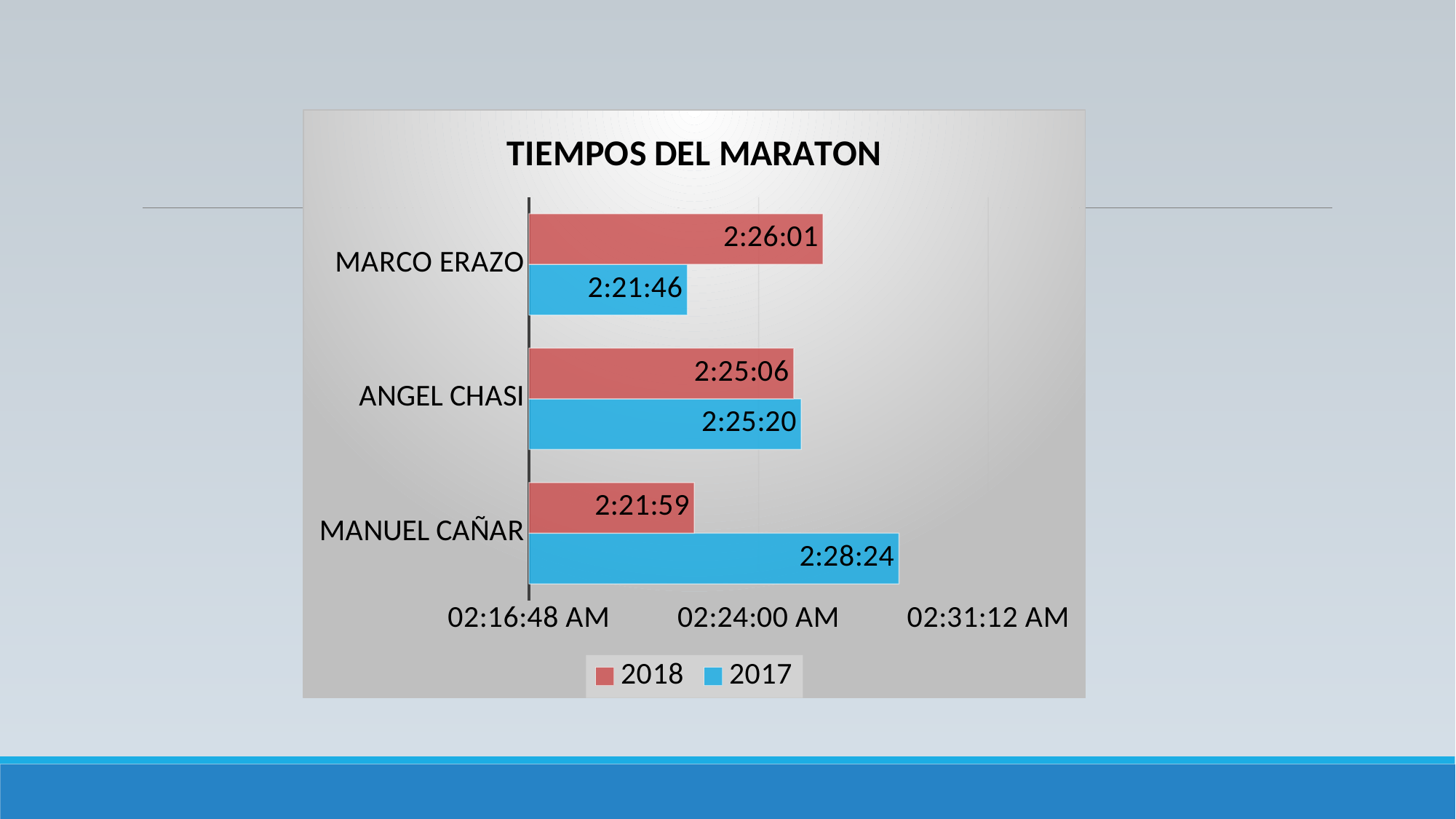
What is the title of the chart? TIEMPOS DEL MARATON What is the 2018 time for MARCO ERAZO? 2:26:01 How many runners are shown on the chart? 3 What is the 2017 time for MANUEL CAÑAR? 2:28:24 What type of chart is shown on the slide? bar chart How many series does the legend list? 2 Which colour represents the 2018 series? red For ANGEL CHASI, which year's time is longer, 2018 or 2017? 2017 Which runner has the shortest 2018 time? MANUEL CAÑAR What is the 2017 time for ANGEL CHASI? 2:25:20 Is the 2017 time for MARCO ERAZO greater or less than 02:24:00 AM? less Which runner has the longest 2017 time? MANUEL CAÑAR